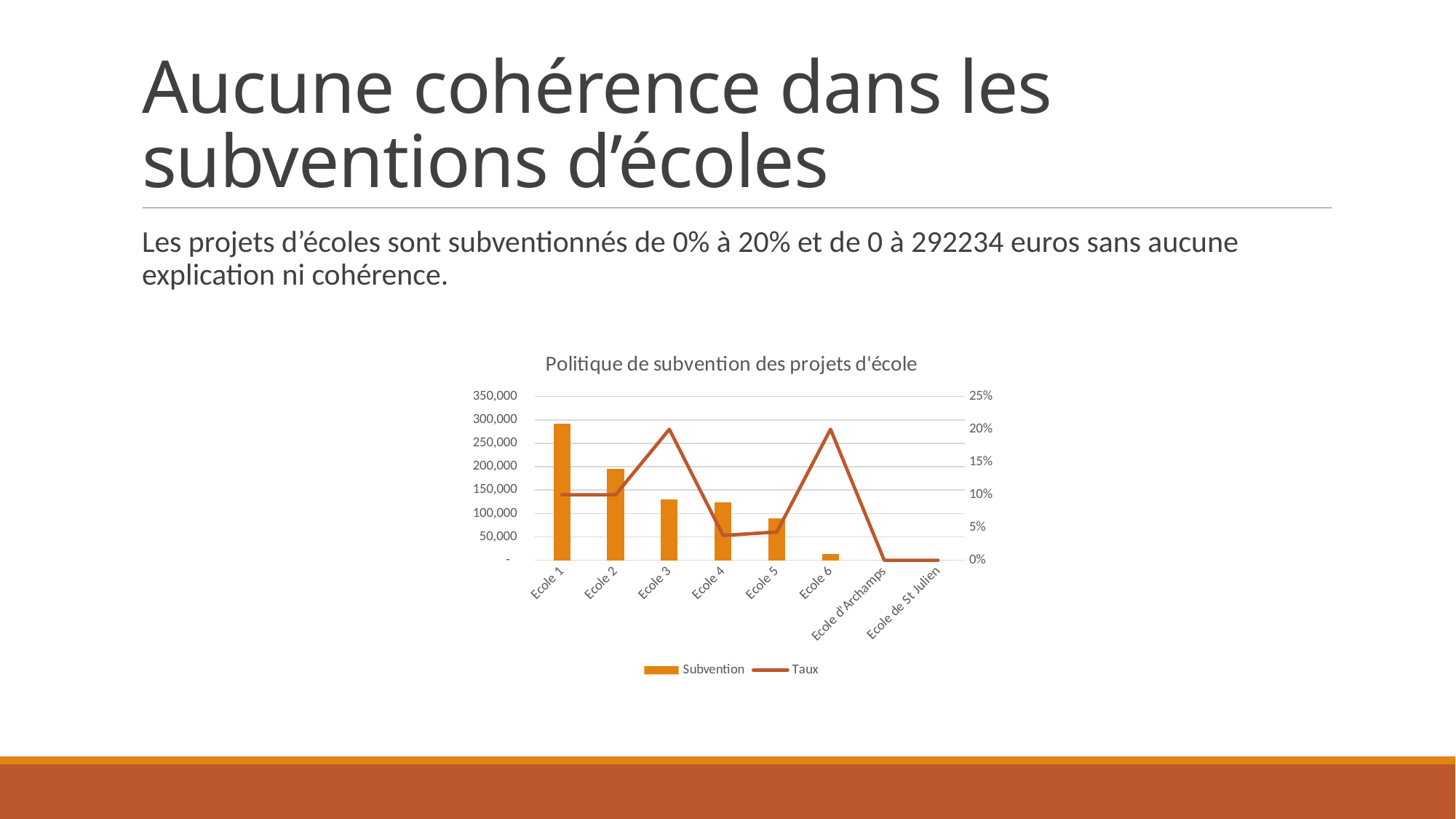
Which school has the highest Subvention bar? Ecole 1 Which has the larger Subvention bar, Ecole 2 or Ecole 3? Ecole 2 Is the Subvention value for Ecole 5 greater or less than 100,000? less Do the Subvention bars rise or fall from Ecole 1 to Ecole 6? fall How many series does the chart legend list? 2 What is the Taux value for Ecole 1? 10% What is the Taux value for Ecole 3? 20% What kind of chart is shown on the slide? A combined bar and line chart Is the Subvention value for Ecole 2 greater or less than 150,000? greater What is the title of the chart? Politique de subvention des projets d'école What is the Taux value for Ecole d'Archamps? 0% How many schools (categories) are shown on the x axis of the chart? 8